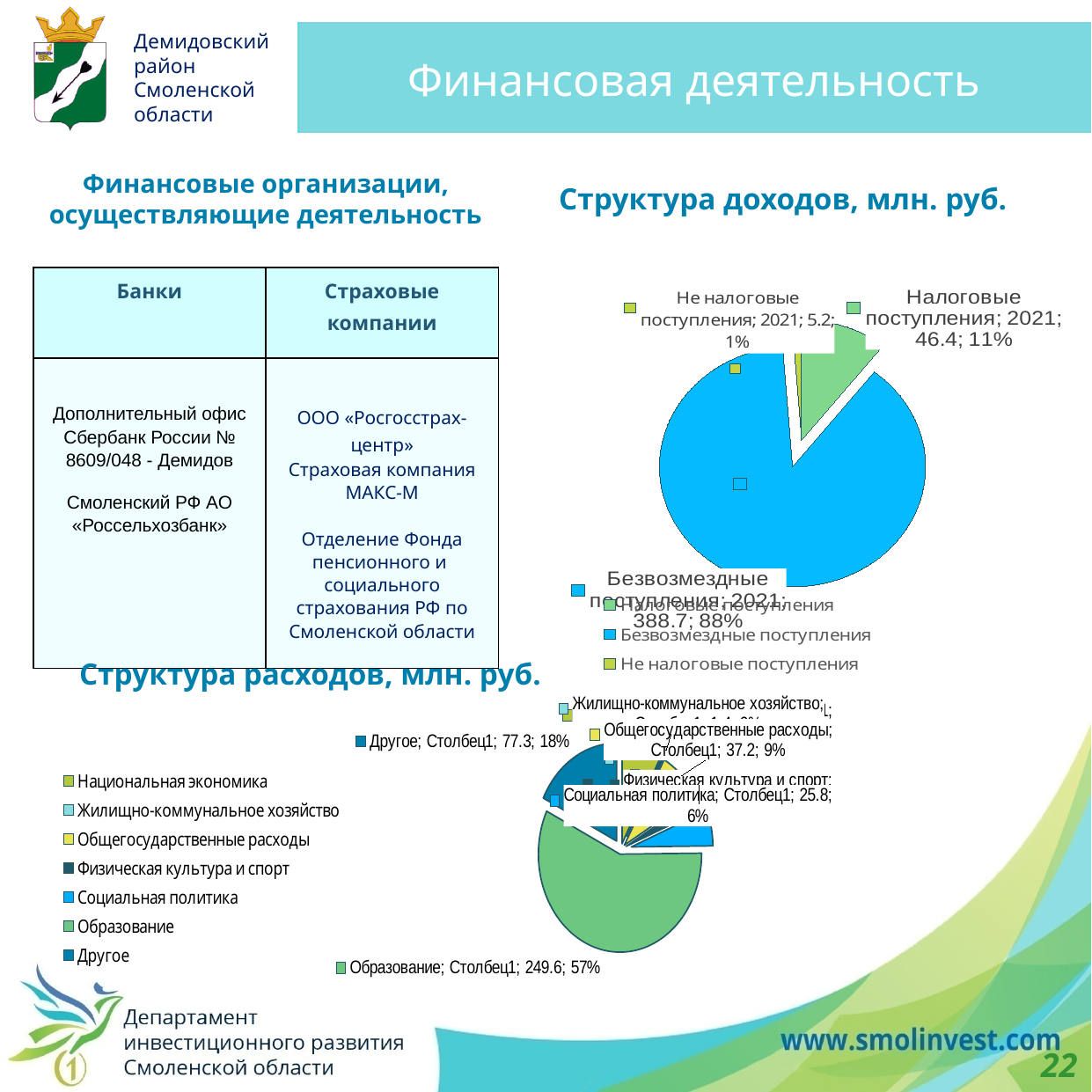
In the "Структура доходов, млн. руб." chart, what is the difference between Налоговые поступления and Не налоговые поступления? 41.2 In the "Структура доходов, млн. руб." chart, what is the value for Налоговые поступления? 46.4 In the "Структура доходов, млн. руб." chart, what share of the pie is Не налоговые поступления? 1% In the "Структура расходов, млн. руб." chart, what share of the pie is Другое? 18% In the "Структура доходов, млн. руб." chart, what is the value for Безвозмездные поступления? 388.7 How many categories does the legend of the "Структура доходов, млн. руб." chart list? 3 In the "Структура расходов, млн. руб." chart, which is larger: Общегосударственные расходы or Социальная политика? Общегосударственные расходы What kind of chart is the "Структура доходов, млн. руб." chart? pie chart In the "Структура доходов, млн. руб." chart, which category has the smallest slice? Не налоговые поступления In the "Структура доходов, млн. руб." chart, which category has the largest slice? Безвозмездные поступления How many categories does the legend of the "Структура расходов, млн. руб." chart list? 7 In the "Структура расходов, млн. руб." chart, what is the value for Образование? 249.6